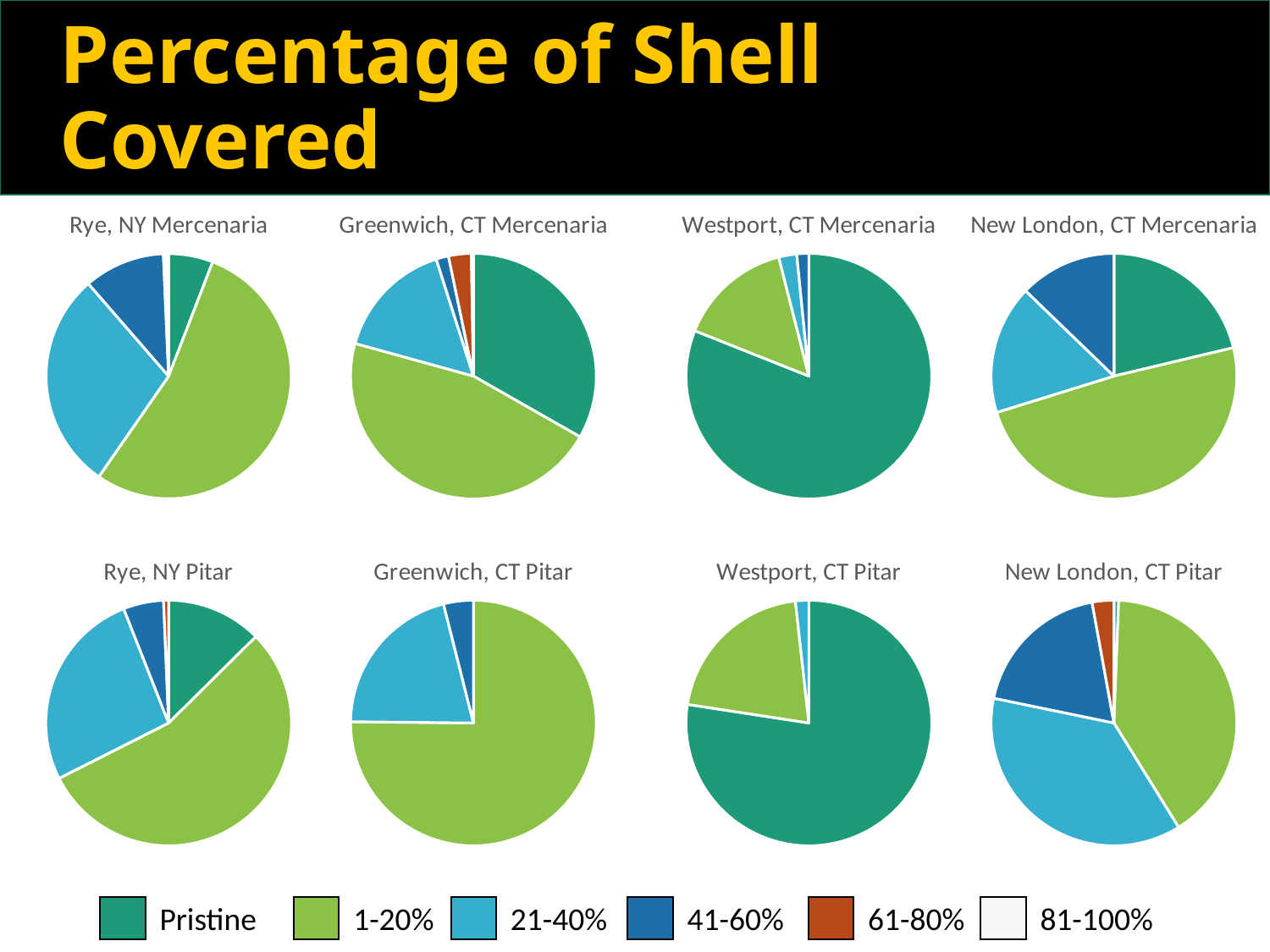
In the Rye, NY Mercenaria pie chart, which slice is larger: 21-40% or 41-60%? 21-40% What is the title of the slide? Percentage of Shell Covered In the Westport, CT Pitar pie chart, how many slices are there? 3 How many categories does the legend list? 6 In the Greenwich, CT Pitar pie chart, which category has the smallest slice? 41-60% In the Westport, CT Pitar pie chart, which category has the smallest slice? 21-40% How many pie charts are on the slide? 8 What kind of charts are shown on the slide? Pie charts In the Greenwich, CT Pitar pie chart, which category has the largest slice? 1-20% In the Rye, NY Mercenaria pie chart, which category has the largest slice? 1-20% In the Westport, CT Mercenaria pie chart, which category has the largest slice? Pristine